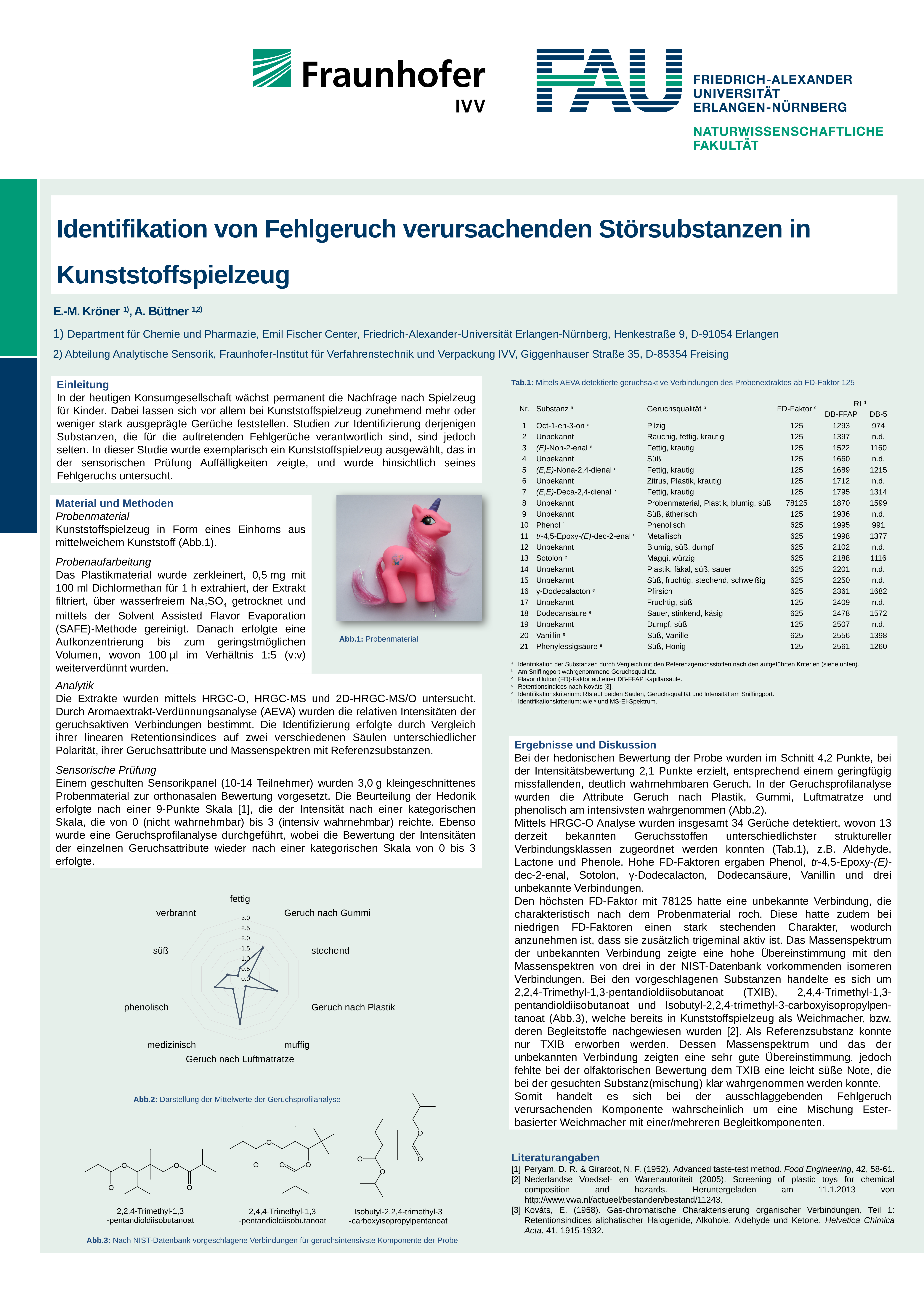
In the radar chart Abb.2, is the value for Geruch nach Plastik greater or less than 1.0? greater In the radar chart Abb.2, is the value for Geruch nach Luftmatratze greater or less than 1.0? greater In the radar chart Abb.2, is the value for stechend greater or less than 1.5? less What is the caption of the radar chart (Abb.2)? Darstellung der Mittelwerte der Geruchsprofilanalyse In the radar chart Abb.2, which is larger: the value for Geruch nach Luftmatratze or the value for medizinisch? Geruch nach Luftmatratze What is the highest value shown on the axis scale of the radar chart Abb.2? 3.0 How many odour attributes (categories) are plotted in the radar chart Abb.2? 10 In the radar chart Abb.2, which is larger: the value for Geruch nach Plastik or the value for muffig? Geruch nach Plastik What kind of chart is Abb.2? radar chart